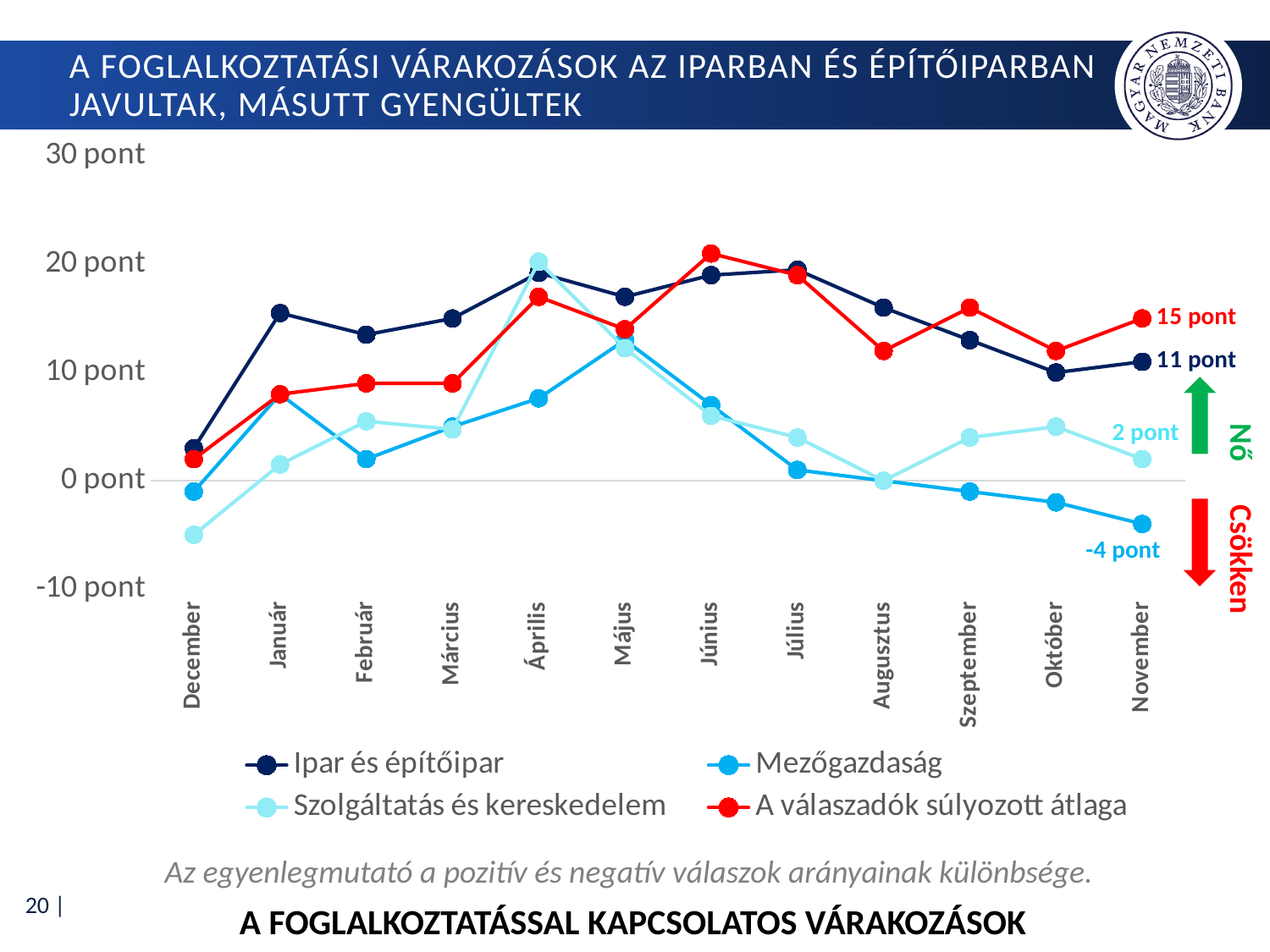
Does the 'Mezőgazdaság' series rise or fall from Május to November? fall What is the value for 'Szolgáltatás és kereskedelem' in November? 2 pont How many series does the legend list? 4 What is the value for 'A válaszadók súlyozott átlaga' in November? 15 pont What is the value for 'Ipar és építőipar' in November? 11 pont In November, which is larger: 'Ipar és építőipar' or 'Mezőgazdaság'? Ipar és építőipar Which series has the highest value in November? A válaszadók súlyozott átlaga Is the value for 'Ipar és építőipar' in Április greater or less than 10 pont? greater What kind of chart is shown on the slide? line chart In November, what is the difference between 'A válaszadók súlyozott átlaga' and 'Ipar és építőipar'? 4 pont What is the value for 'Mezőgazdaság' in November? -4 pont How many months are shown on the x axis? 12